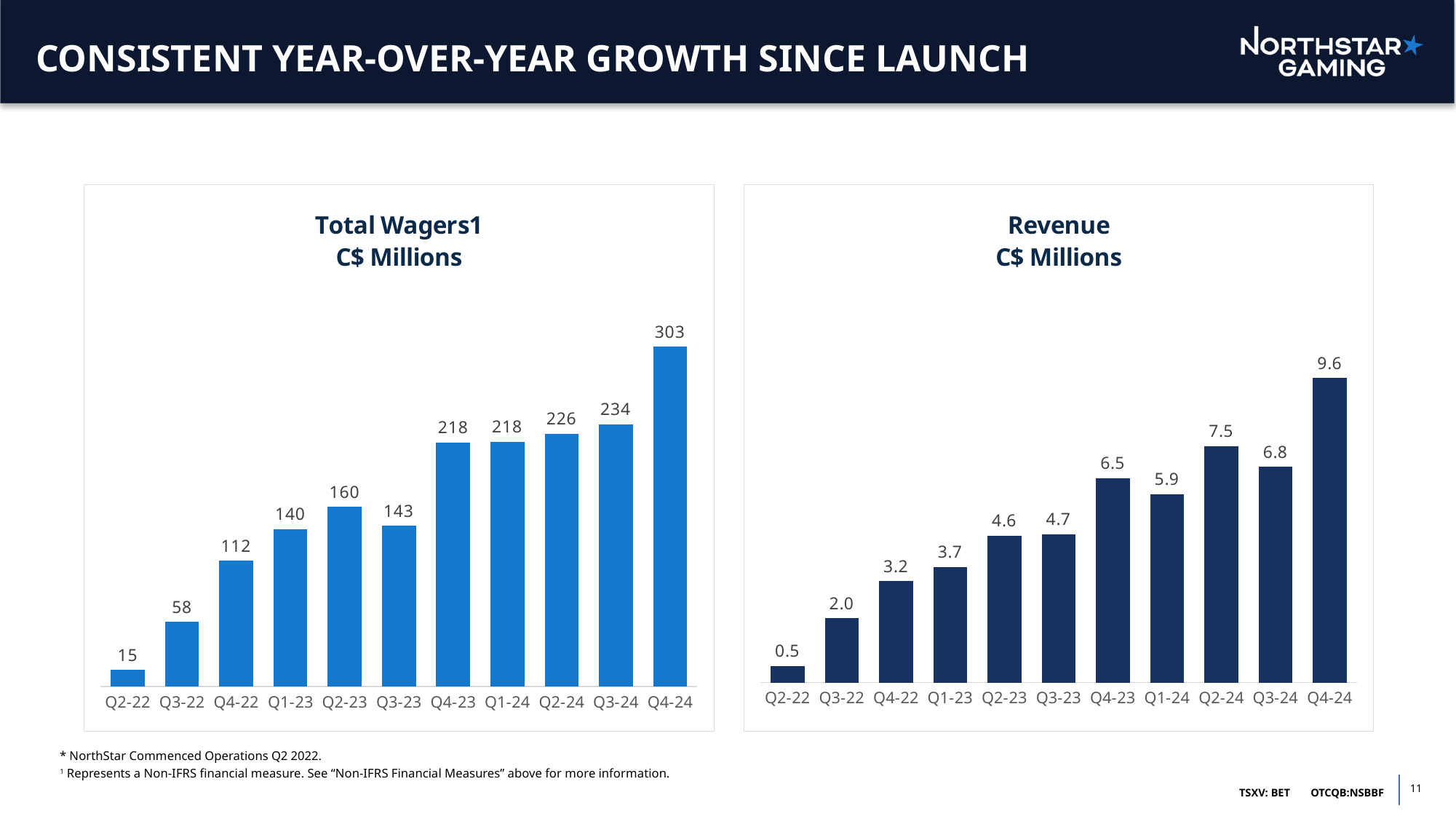
In the Revenue chart, what is the difference between Q2-24 and Q3-24? 0.7 How many quarters are shown in the Revenue chart? 11 In the Total Wagers chart, which is larger, Q2-23 or Q3-23? Q2-23 What kind of chart is the Total Wagers chart? Bar chart In the Total Wagers chart, which quarter has the lowest value? Q2-22 In the Total Wagers chart, what is the difference between Q4-24 and Q3-24? 69 In the Revenue chart, do values generally rise or fall from Q2-22 to Q4-24? Rise In the Revenue chart, which is larger, Q4-23 or Q1-24? Q4-23 What unit is stated in the title of the Revenue chart? C$ Millions In the Revenue chart, which quarter has the highest value? Q4-24 In the Revenue chart, what is the value for Q1-24? 5.9 In the Total Wagers chart, what is the value for Q4-24? 303